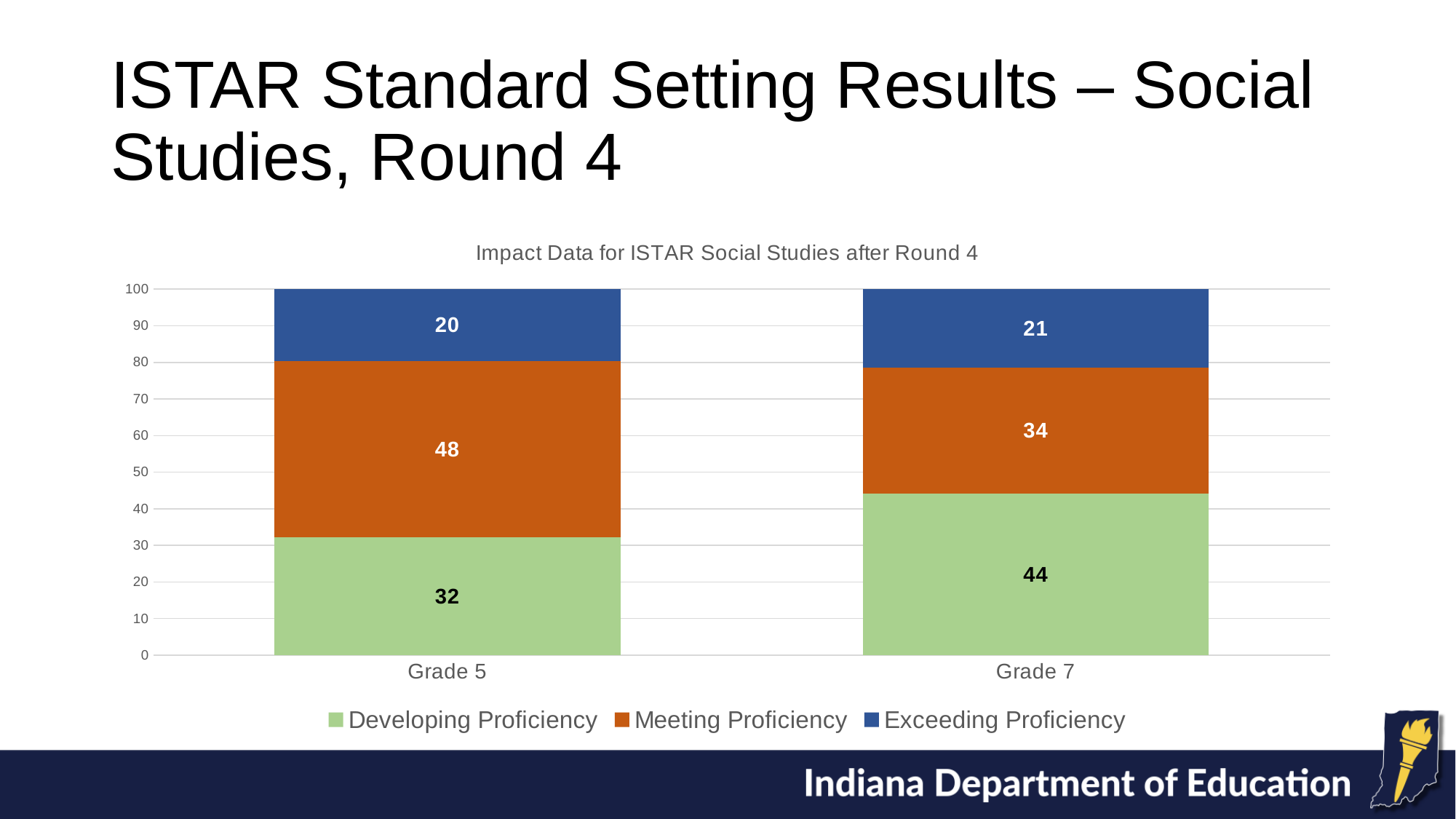
Which grade has the lower Developing Proficiency value? Grade 5 What is the difference between the Developing Proficiency values for Grade 7 and Grade 5? 12 What is the total of the stacked bar for Grade 5? 100 How many series does the legend list? 3 What kind of chart is shown? Stacked bar chart What is the Developing Proficiency value for Grade 7? 44 What is the difference between the Meeting Proficiency values for Grade 5 and Grade 7? 14 How many grades are shown on the x axis? 2 What is the Meeting Proficiency value for Grade 5? 48 Which grade has the higher Meeting Proficiency value? Grade 5 What is the title of the chart? Impact Data for ISTAR Social Studies after Round 4 What is the Exceeding Proficiency value for Grade 7? 21